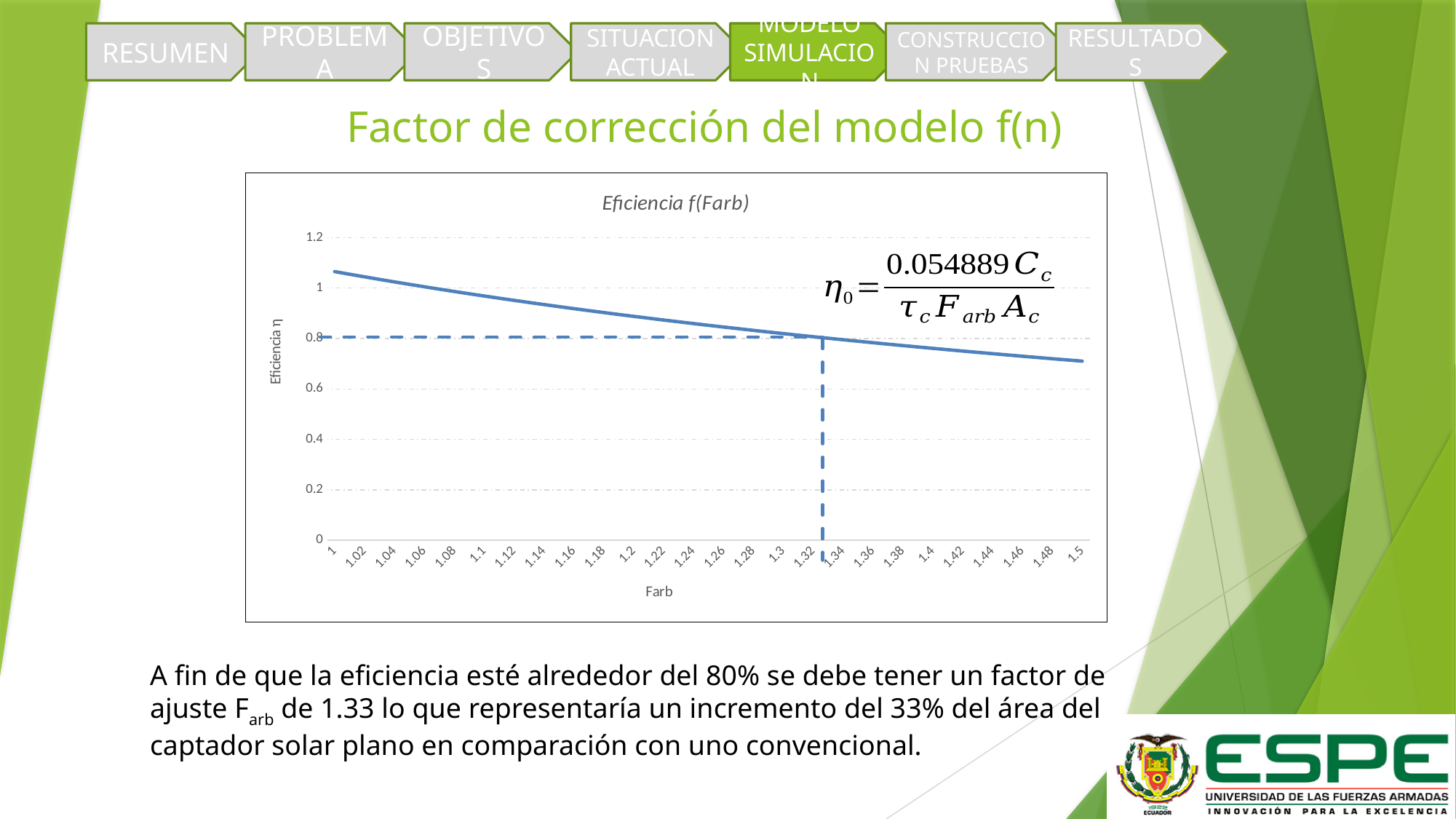
Which has the higher efficiency, Farb = 1.1 or Farb = 1.4? Farb = 1.1 What is the label of the x axis of the chart? Farb Is the efficiency at Farb = 1.5 greater or less than 0.8? less At which Farb value is the efficiency highest? 1 At which Farb value is the efficiency lowest? 1.5 Is the efficiency at Farb = 1 greater or less than 1? greater Does the efficiency rise or fall as Farb increases along the x axis? fall Is the efficiency at Farb = 1.2 greater or less than 0.8? greater What type of chart is shown on the slide? line chart At what efficiency value is the horizontal dashed line drawn on the chart? 0.8 What is the title of the chart? Eficiencia f(Farb)